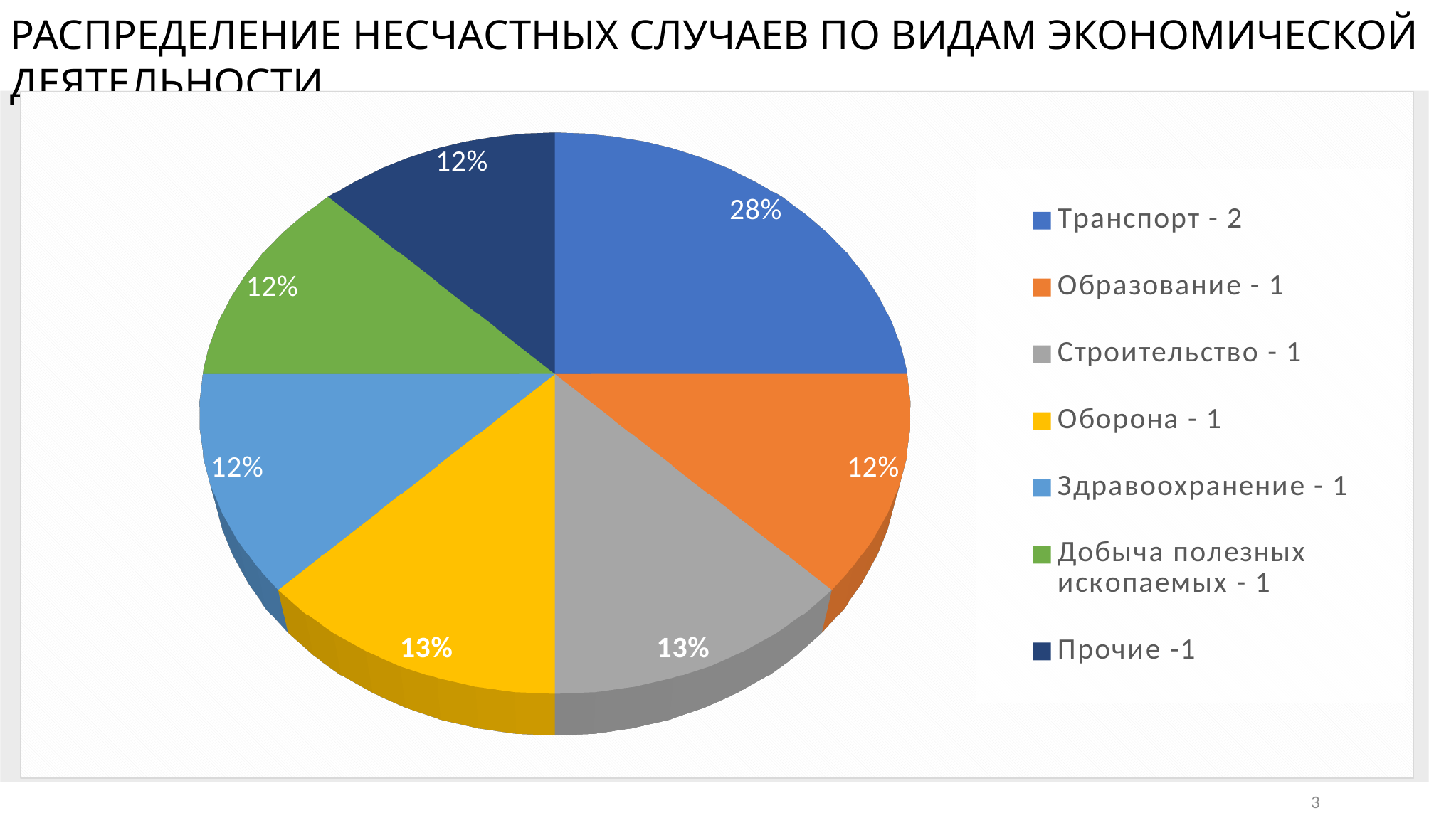
Which category has the largest slice of the pie? Транспорт What share of the pie does Строительство account for? 13% Which is larger, the share for Транспорт or the share for Прочие? Транспорт How many entries does the legend list? 7 What share of the pie does Транспорт account for? 28% What number of cases does the legend show for Транспорт? 2 By how many percentage points does the share for Транспорт exceed the share for Образование? 16 How many slices does the pie chart have? 7 What share of the pie does Здравоохранение account for? 12% What kind of chart is shown on the slide? pie chart